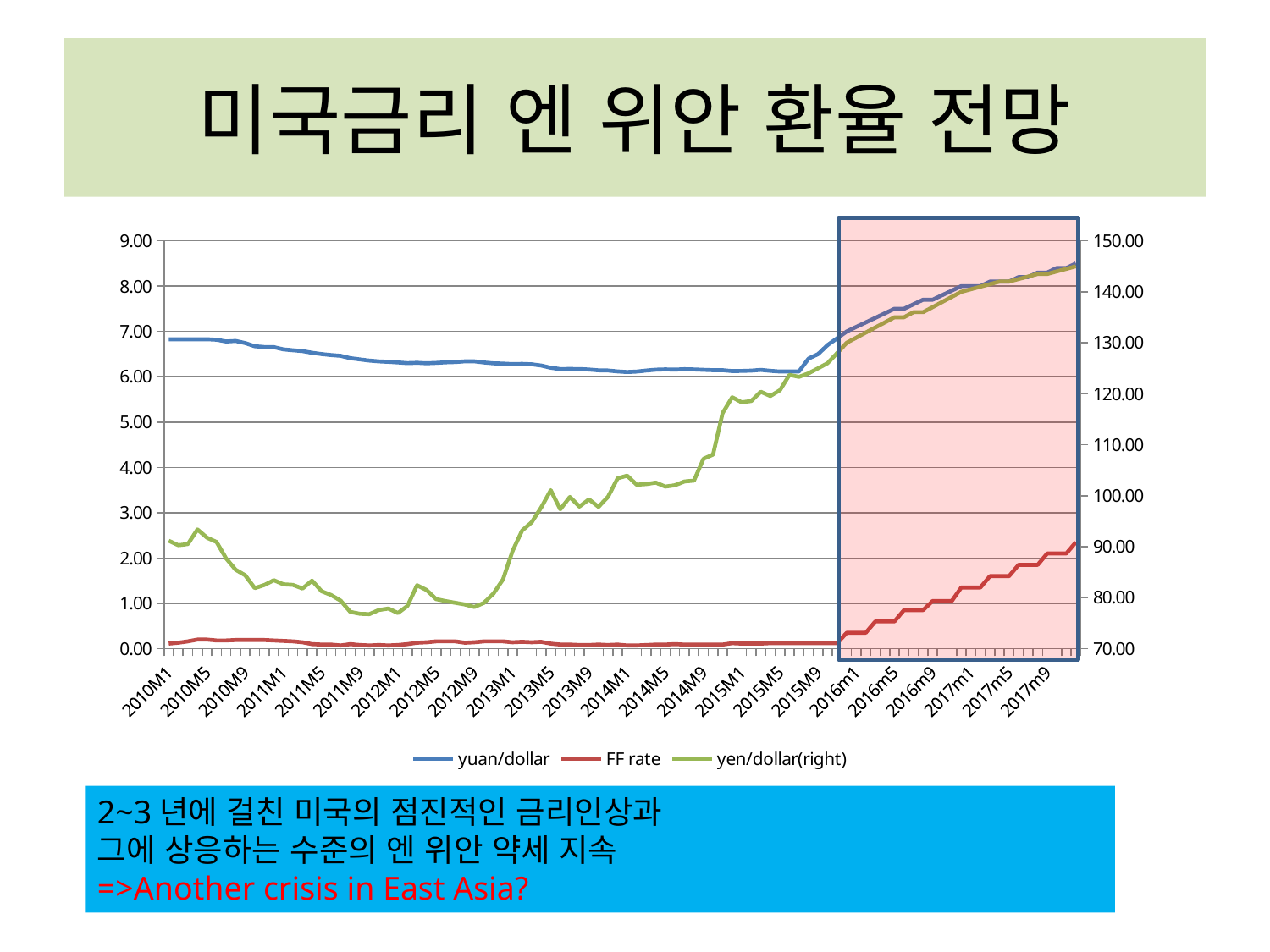
Does the FF rate line rise or fall from 2016m1 to 2017m9? rise Is the yuan/dollar value at 2010M1 greater or less than 6.00? greater What colour is the FF rate line in the chart? red Is the yuan/dollar value at 2017m9 greater or less than 8.00? greater At 2010M1, which is larger on the left axis: yuan/dollar or FF rate? yuan/dollar Is the yen/dollar(right) value at 2015M1 greater or less than 110.00 on the right axis? greater How many series does the chart legend list? 3 Which series in the legend is plotted against the right-hand axis? yen/dollar(right) Does the yuan/dollar line rise or fall from 2010M1 to 2015M5? fall What kind of chart is shown on the slide? line chart